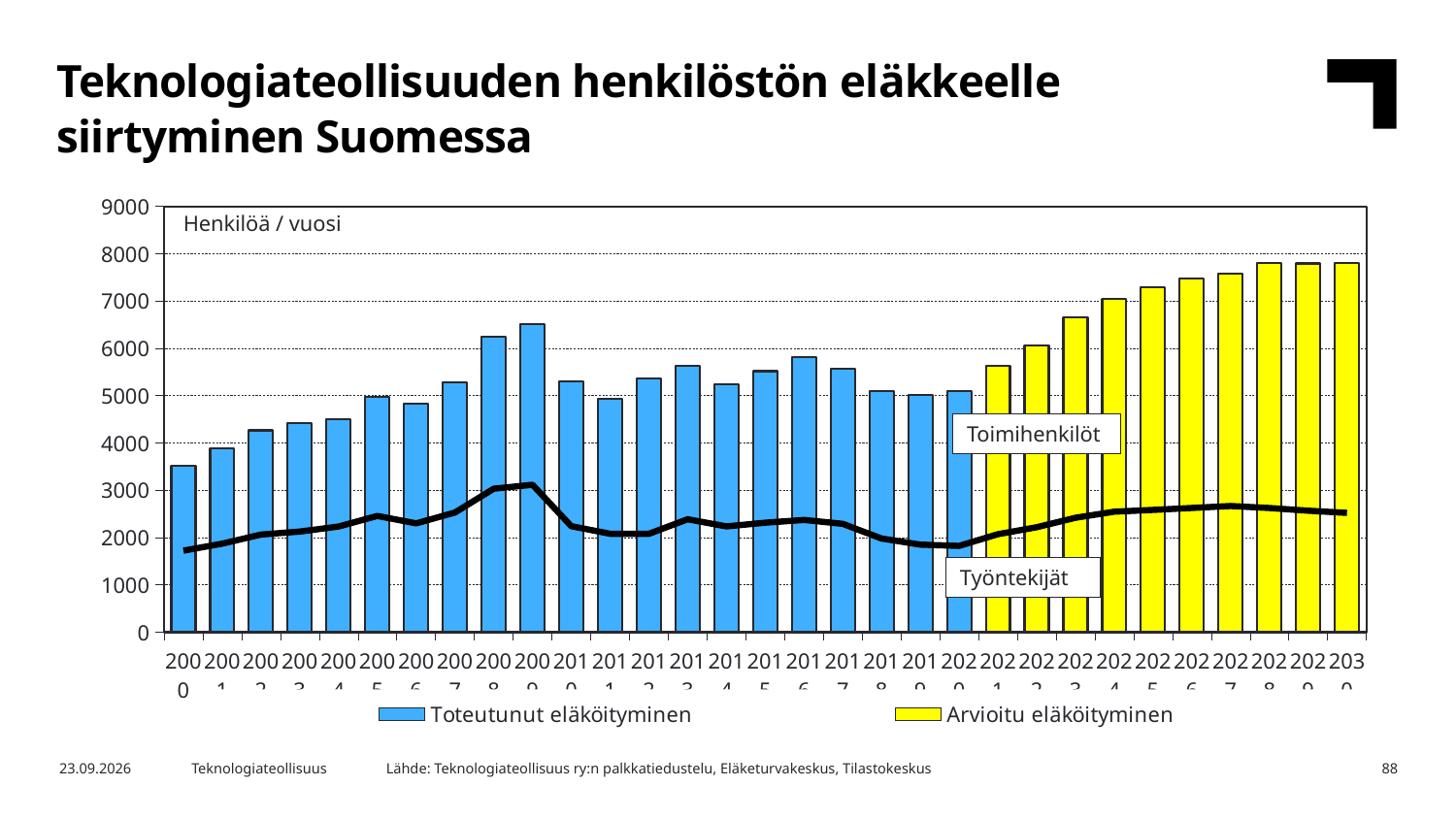
Is the bar value for 2009 greater or less than 6000? greater Do the bar values rise or fall from 2020 to 2030? rise Is the bar value for 2030 greater or less than 8000? less How many years (bars) are plotted on the x axis? 31 Which year has the lowest bar in the chart? 2000 How many series does the legend list? 2 What kind of chart is shown on the slide? combination bar and line chart Which bar is taller, 2009 or 2008? 2009 What are the two legend entries of the chart? Toteutunut eläköityminen, Arvioitu eläköityminen Is the bar value for 2000 greater or less than 3000? greater What unit label is shown inside the plot area of the chart? Henkilöä / vuosi